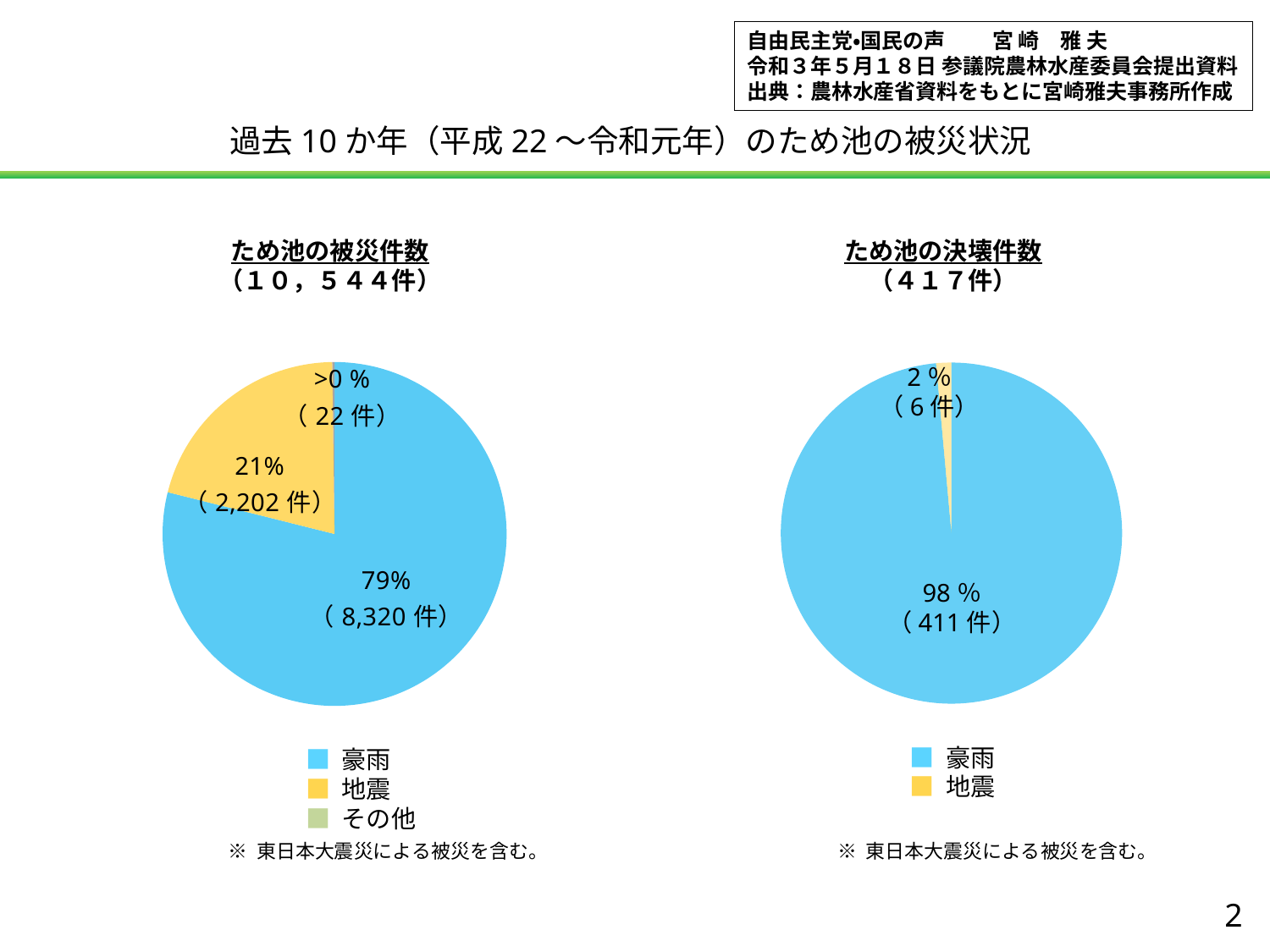
In the left pie chart (ため池の被災件数), how many cases (件) are attributed to 地震? 2,202 件 In the left pie chart (ため池の被災件数), what percentage share does 豪雨 have? 79% In the left pie chart (ため池の被災件数), which category has the smallest share? その他 In the left pie chart (ため池の被災件数), which category has the largest share? 豪雨 In the right pie chart (ため池の決壊件数), how many cases (件) are attributed to 地震? 6 件 What type of chart is used for ため池の決壊件数 on the right? Pie chart In the right pie chart (ため池の決壊件数), which category has the larger share, 豪雨 or 地震? 豪雨 In the right pie chart (ため池の決壊件数), what percentage share does 豪雨 have? 98 % How many categories does the legend of the right pie chart (ため池の決壊件数) list? 2 In the left pie chart (ため池の被災件数), what is the difference in cases between 豪雨 and 地震? 6,118 件 In the left pie chart (ため池の被災件数), how many cases (件) are attributed to その他? 22 件 How many categories does the legend of the left pie chart (ため池の被災件数) list? 3